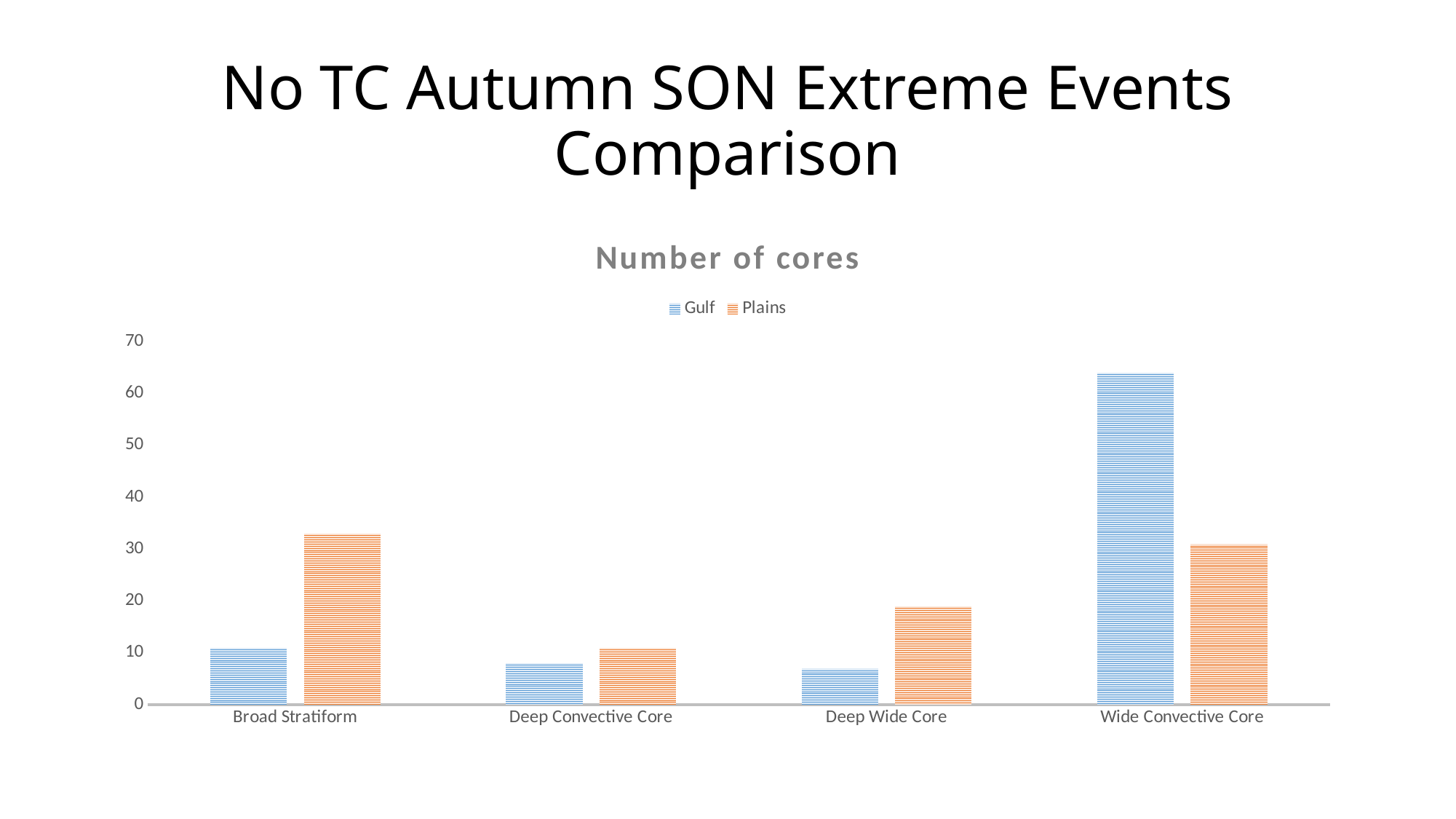
How many series does the legend list? 2 For Broad Stratiform, which is larger, the Gulf value or the Plains value? Plains What is the title of the chart? Number of cores What kind of chart is shown on the slide? bar chart Which category has the lowest Plains value? Deep Convective Core Which category has the highest Plains value? Broad Stratiform Which category has the highest Gulf value? Wide Convective Core How many categories are shown on the x axis? 4 Is the Gulf value for Deep Wide Core greater or less than 10? less For Wide Convective Core, which is larger, the Gulf value or the Plains value? Gulf Is the Gulf value for Wide Convective Core greater or less than 60? greater Is the Plains value for Broad Stratiform greater or less than 30? greater